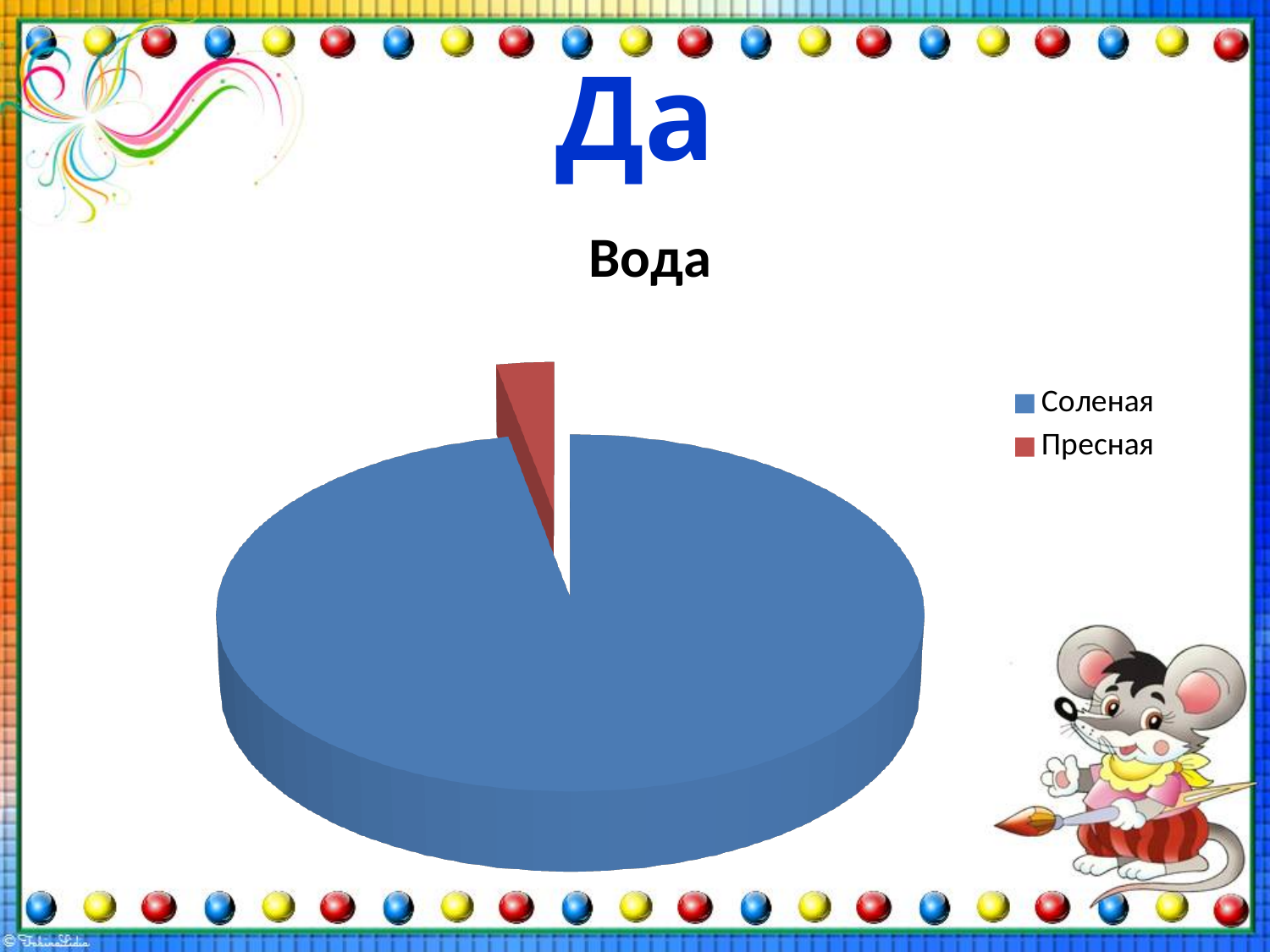
Which is larger, the slice for Соленая or the slice for Пресная? Соленая Which category is shown in blue? Соленая Which category has the largest slice of the pie? Соленая How many slices does the pie chart have? 2 What colour is the slice for Пресная? Red Which category has the smallest slice of the pie? Пресная What is the title of the chart? Вода How many entries does the legend list? 2 What kind of chart is shown on the slide? Pie chart